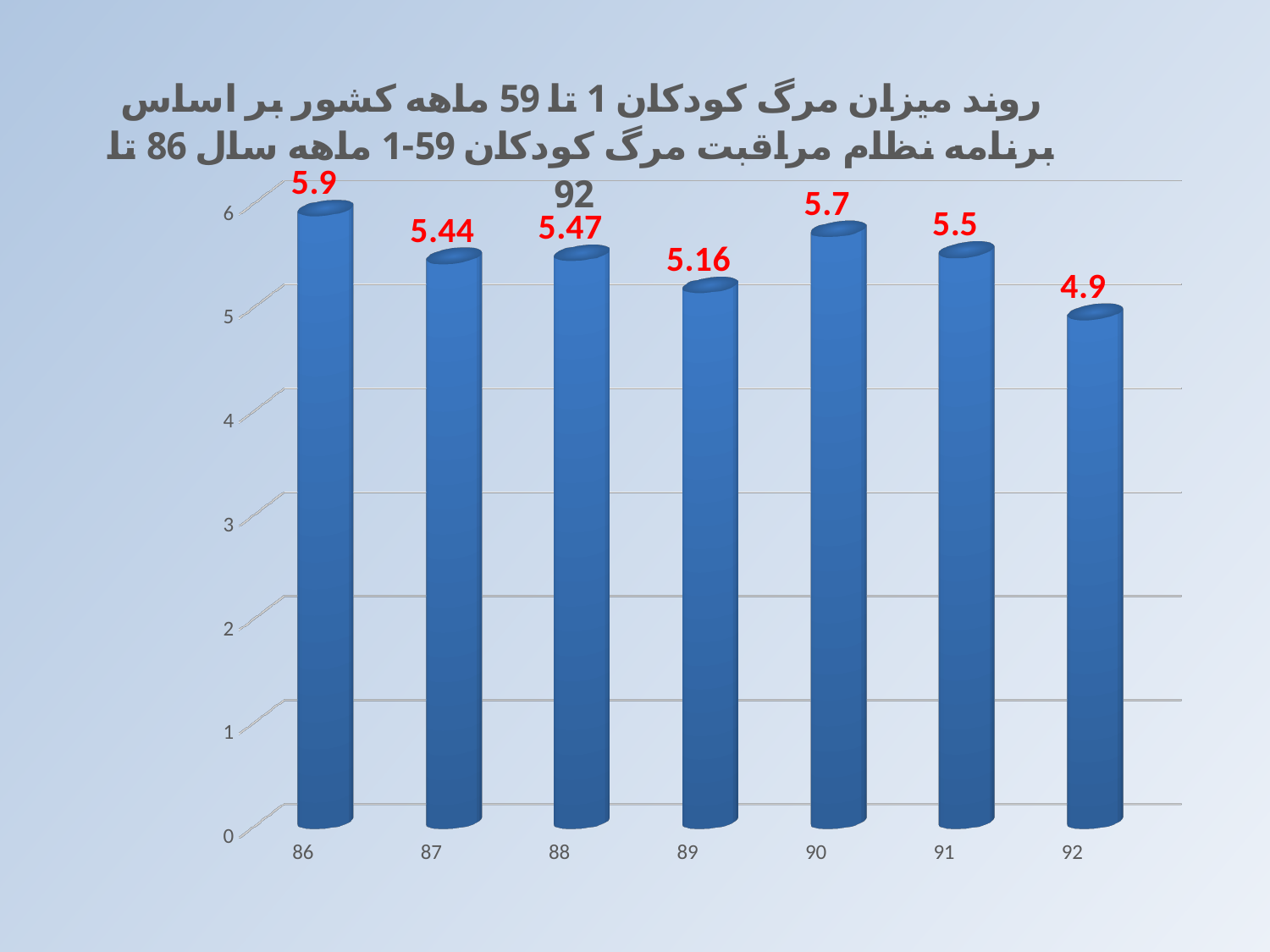
Which year has the highest value? 86 What is the value for year 92? 4.9 Which year has the lowest value? 92 What is the difference between the values for year 86 and year 92? 1 Does the value rise or fall from year 91 to year 92? fall Is the value for year 92 greater or less than 5? less What is the value for year 89? 5.16 What is the difference between the values for year 90 and year 89? 0.54 What kind of chart is shown on the slide? bar chart What is the value for year 86? 5.9 Which is larger, the value for year 90 or the value for year 91? 90 How many years are shown on the x axis? 7